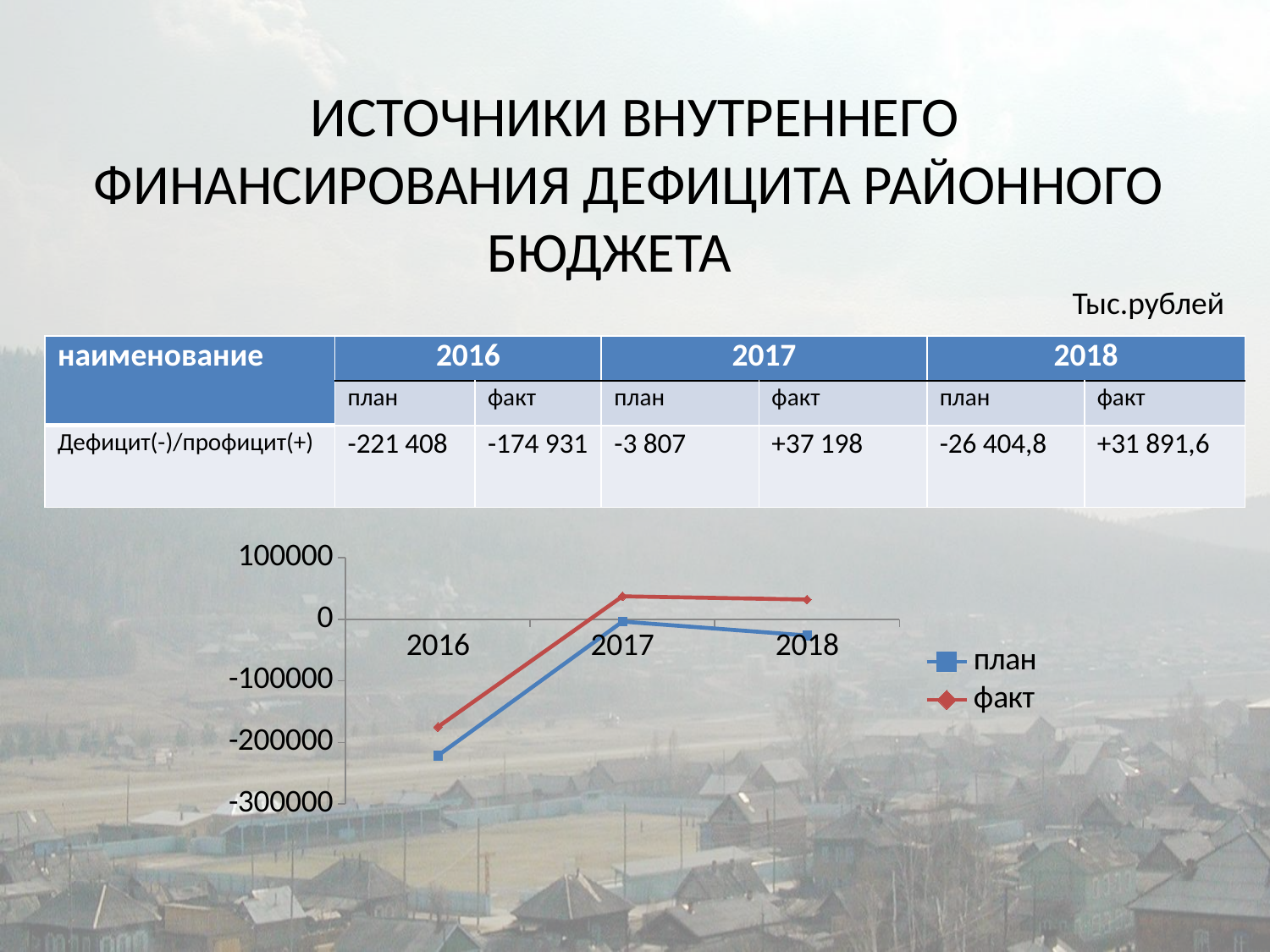
What kind of chart is shown on the slide? line chart What is the difference between the факт and план values for 2016 given in the table? 46 477 On the chart, is the факт value for 2016 greater or less than -200000? greater What is the план value for 2016 shown in the table? -221 408 In 2018, which series has the larger value, план or факт? факт Does the план line rise or fall from 2016 to 2017? rise How many years are plotted along the x axis of the chart? 3 In which year is the план value lowest? 2016 How many series does the chart legend list? 2 On the chart, is the план value for 2016 greater or less than -200000? less What is the факт value for 2018 shown in the table? +31 891,6 What is the факт value for 2017 shown in the table? +37 198